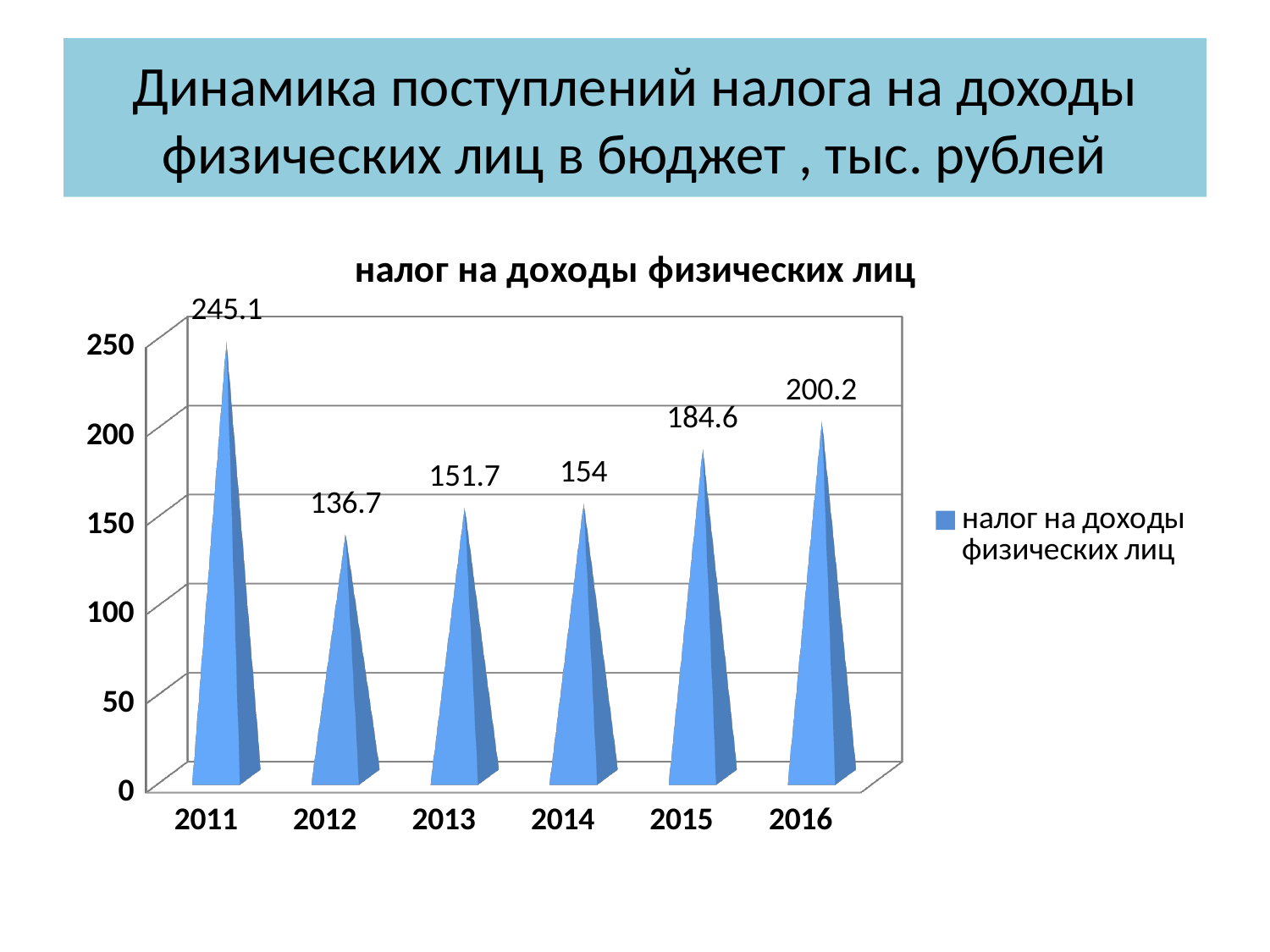
Which year has the highest value? 2011 What is the value for 2016? 200.2 Do the values rise or fall from 2012 to 2016? rise What is the difference between the values for 2016 and 2015? 15.6 Which is larger, the value for 2013 or the value for 2015? 2015 Which year has the lowest value? 2012 What is the difference between the values for 2011 and 2012? 108.4 What is the value for 2014? 154 What is the value for 2011? 245.1 How many years are shown on the x axis? 6 Is the value for 2012 greater or less than 150? less What kind of chart is this? bar chart